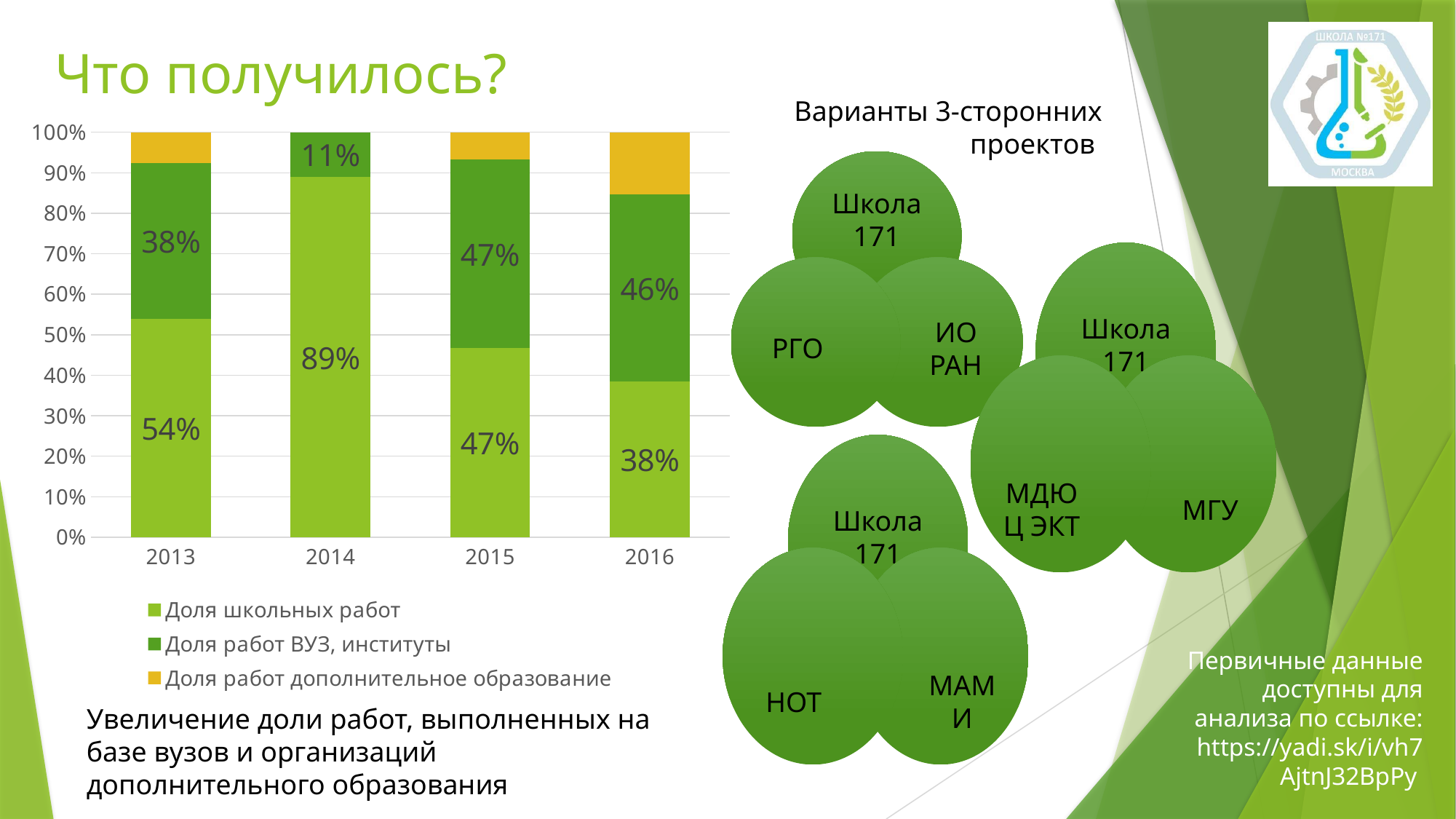
Which is larger in 2013: the share of school works or the share of university works? Доля школьных работ (54%) What is the difference between the share of school works and the share of university works in 2013? 16 percentage points What share of school works (Доля школьных работ) is shown for 2014? 89% What is the value for Доля работ ВУЗ, институты in 2016? 46% What type of chart is shown on the slide? Stacked bar chart In which year is the share of works with universities (Доля работ ВУЗ, институты) lowest? 2014 In which year is the share of school works (Доля школьных работ) lowest? 2016 What is the value for Доля школьных работ in 2013? 54% In which year is the share of school works (Доля школьных работ) highest? 2014 How many series does the chart legend list? 3 How many years are shown on the x axis of the chart? 4 Is the share of Доля работ дополнительное образование in 2016 greater or less than 10%? greater